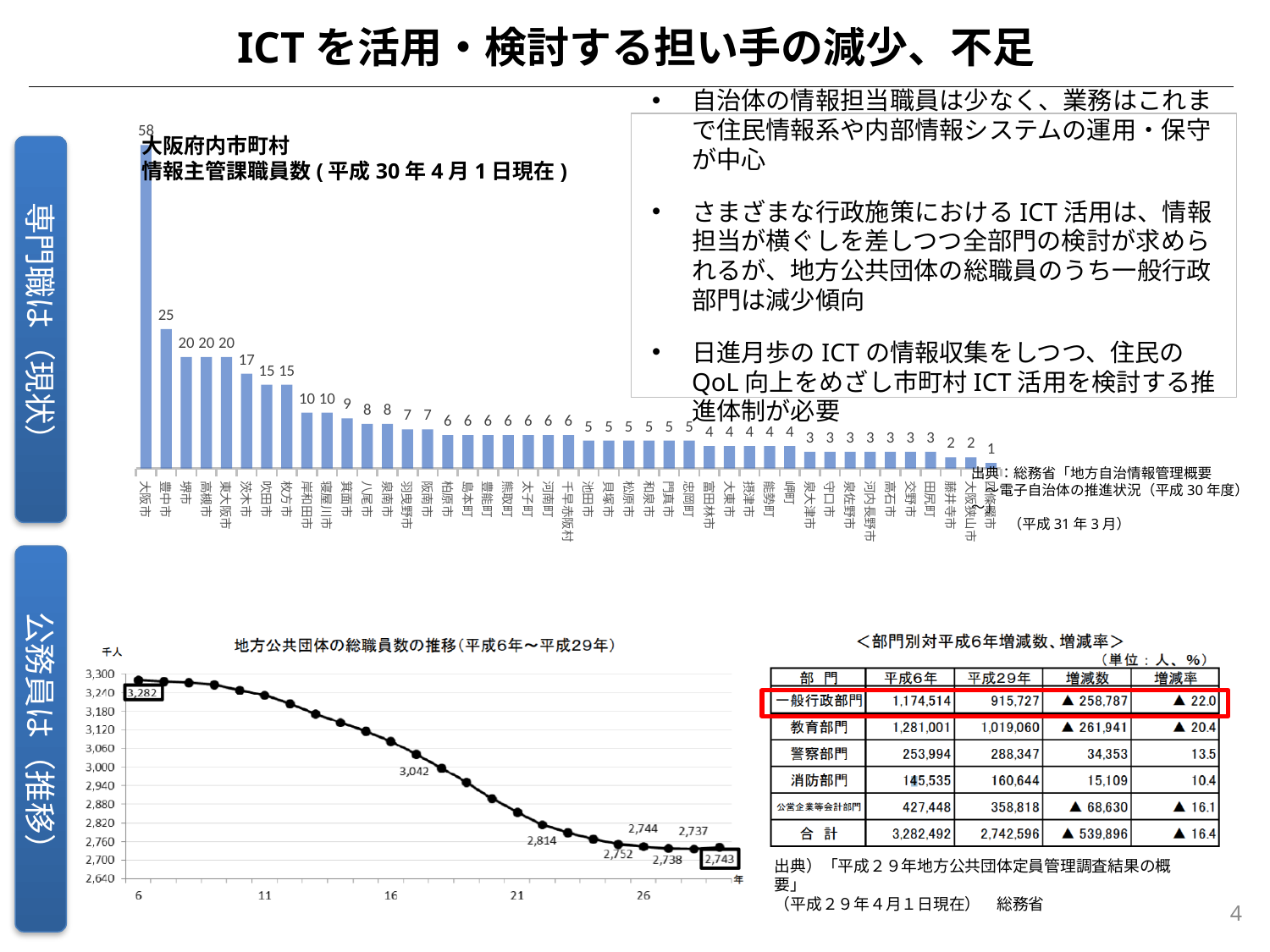
In the top bar chart (大阪府内市町村 情報主管課職員数), what is the value for 大阪市? 58 What kind of chart is the top chart titled 大阪府内市町村 情報主管課職員数? bar chart In the top bar chart (大阪府内市町村 情報主管課職員数), what is the value for 箕面市? 9 In the bottom-left line chart (地方公共団体の総職員数の推移), what unit is shown on the y axis? 千人 What kind of chart is the bottom-left chart titled 地方公共団体の総職員数の推移? line chart In the top bar chart (大阪府内市町村 情報主管課職員数), what is the difference between the values for 大阪市 and 豊中市? 33 In the top bar chart (大阪府内市町村 情報主管課職員数), which municipality has the highest value? 大阪市 In the bottom-left line chart (地方公共団体の総職員数の推移), what is the value labelled at the first point (平成6年)? 3,282 In the bottom-left line chart (地方公共団体の総職員数の推移), what is the value labelled at the last point? 2,743 In the top bar chart (大阪府内市町村 情報主管課職員数), which is larger, the value for 茨木市 or the value for 吹田市? 茨木市 In the bottom-left line chart (地方公共団体の総職員数の推移), do the values generally rise or fall along the x axis? fall In the top bar chart (大阪府内市町村 情報主管課職員数), what is the value for 豊中市? 25